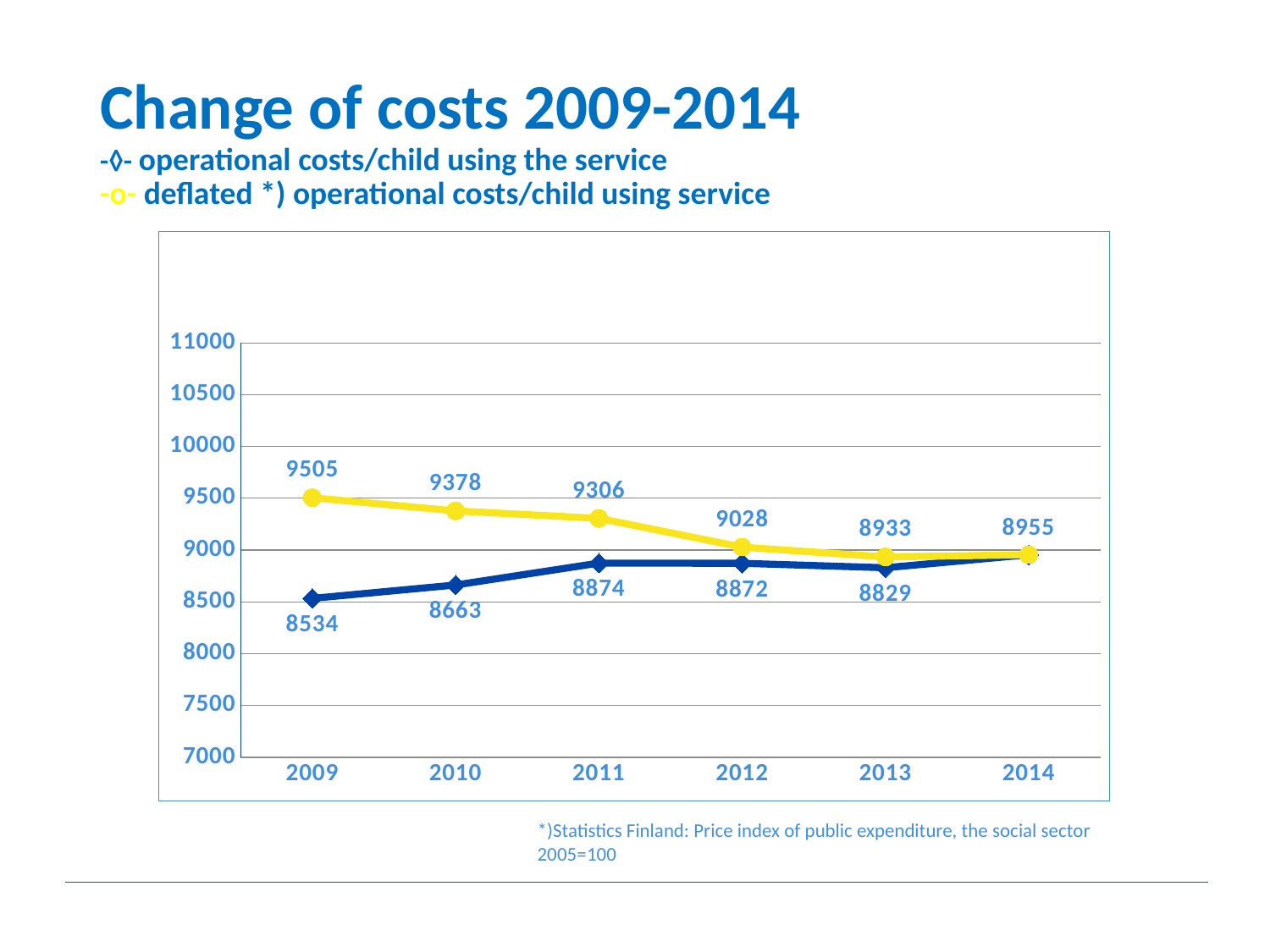
How many years are plotted on the x axis? 6 In which year is the operational costs/child using the service value lowest? 2009 Which series has the larger value in 2010, operational costs/child using the service or deflated operational costs/child using service? deflated operational costs/child using service Does the deflated operational costs/child using service series rise or fall from 2009 to 2013? fall What is the deflated operational costs/child using service value for 2009? 9505 In which year is the deflated operational costs/child using service value highest? 2009 What is the operational costs/child using the service value for 2011? 8874 What is the difference between the deflated value and the operational costs value in 2009? 971 What kind of chart is shown on the slide? line chart Is the operational costs/child using the service value for 2009 greater or less than 9000? less What is the operational costs/child using the service value for 2013? 8829 How many series are shown in the chart? 2